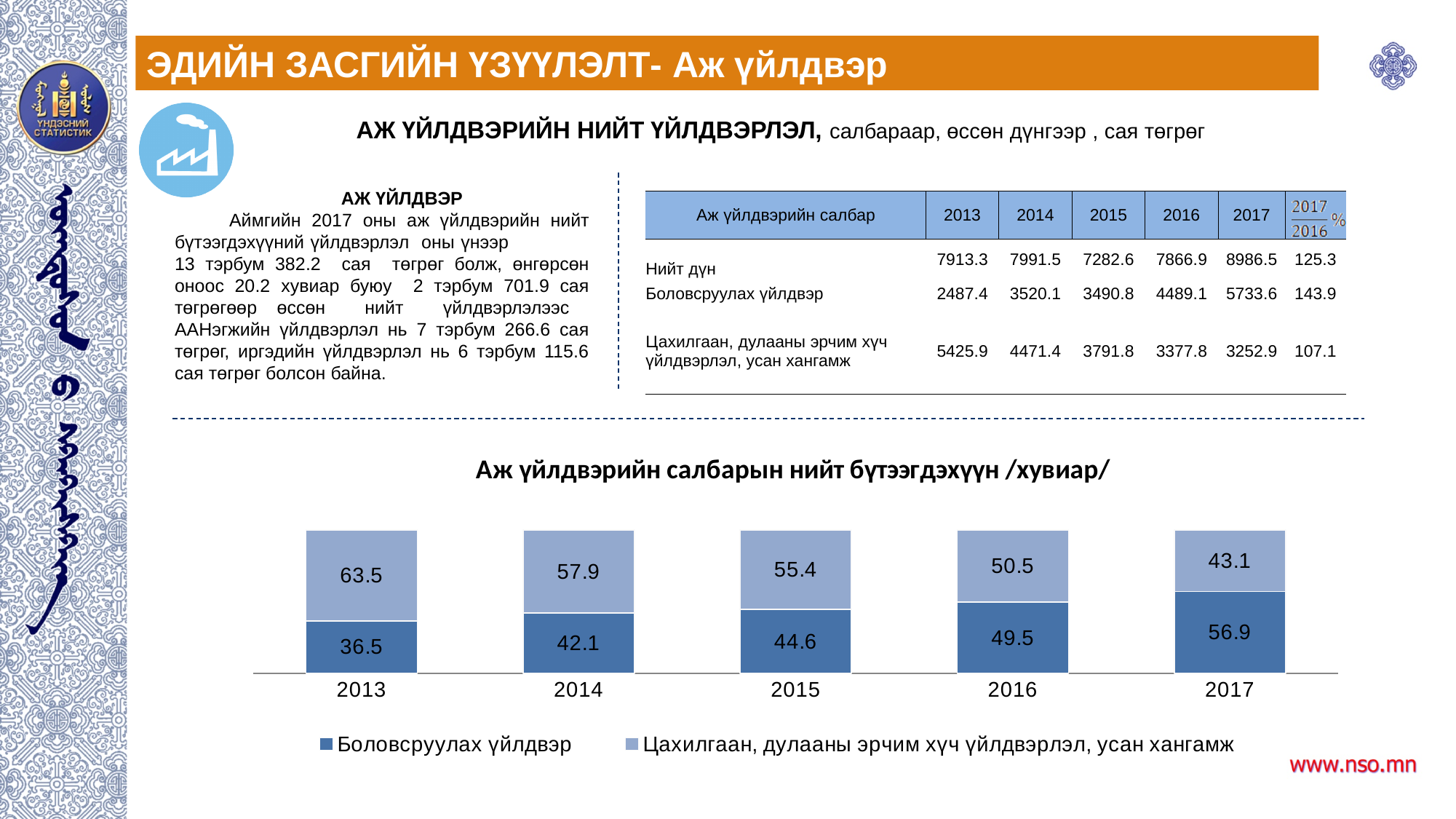
In which year is the value for Боловсруулах үйлдвэр highest? 2017 What is the value for Боловсруулах үйлдвэр in 2016? 49.5 Which is larger in 2015: Боловсруулах үйлдвэр or Цахилгаан, дулааны эрчим хүч үйлдвэрлэл, усан хангамж? Цахилгаан, дулааны эрчим хүч үйлдвэрлэл, усан хангамж How many years are shown on the x axis of the chart? 5 Does the value for Боловсруулах үйлдвэр rise or fall from 2013 to 2017? rise What type of chart is shown on the slide? stacked bar chart In which year is the value for Цахилгаан, дулааны эрчим хүч үйлдвэрлэл, усан хангамж lowest? 2017 What is the value for Боловсруулах үйлдвэр in 2013? 36.5 What is the value for Цахилгаан, дулааны эрчим хүч үйлдвэрлэл, усан хангамж in 2017? 43.1 What is the difference between the Цахилгаан, дулааны эрчим хүч үйлдвэрлэл, усан хангамж value and the Боловсруулах үйлдвэр value in 2013? 27.0 What is the total of the stacked bar for 2014? 100.0 How many series does the chart legend list? 2